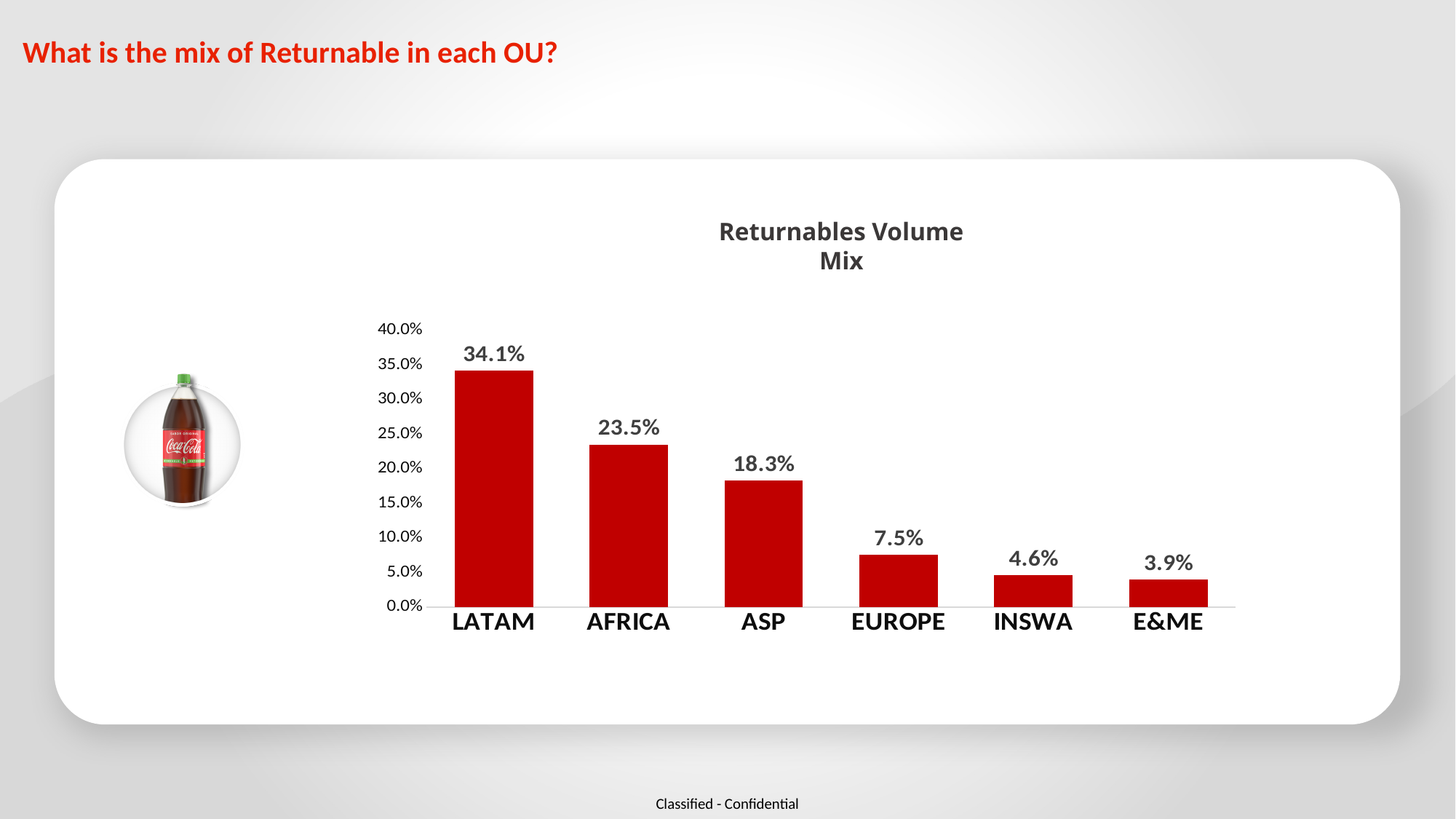
What is the Returnables Volume Mix value for E&ME? 3.9% Which OU has the lowest Returnables Volume Mix? E&ME Do the values rise or fall from left to right across the OUs? Fall What is the Returnables Volume Mix value for LATAM? 34.1% What is the difference between the Returnables Volume Mix of ASP and EUROPE? 10.8% What is the Returnables Volume Mix value for EUROPE? 7.5% Which has a larger Returnables Volume Mix, INSWA or E&ME? INSWA What is the difference between the Returnables Volume Mix of LATAM and AFRICA? 10.6% What kind of chart is used to show the Returnables Volume Mix? Bar chart Which OU has the highest Returnables Volume Mix? LATAM How many OUs are shown in the Returnables Volume Mix chart? 6 What is the Returnables Volume Mix value for AFRICA? 23.5%